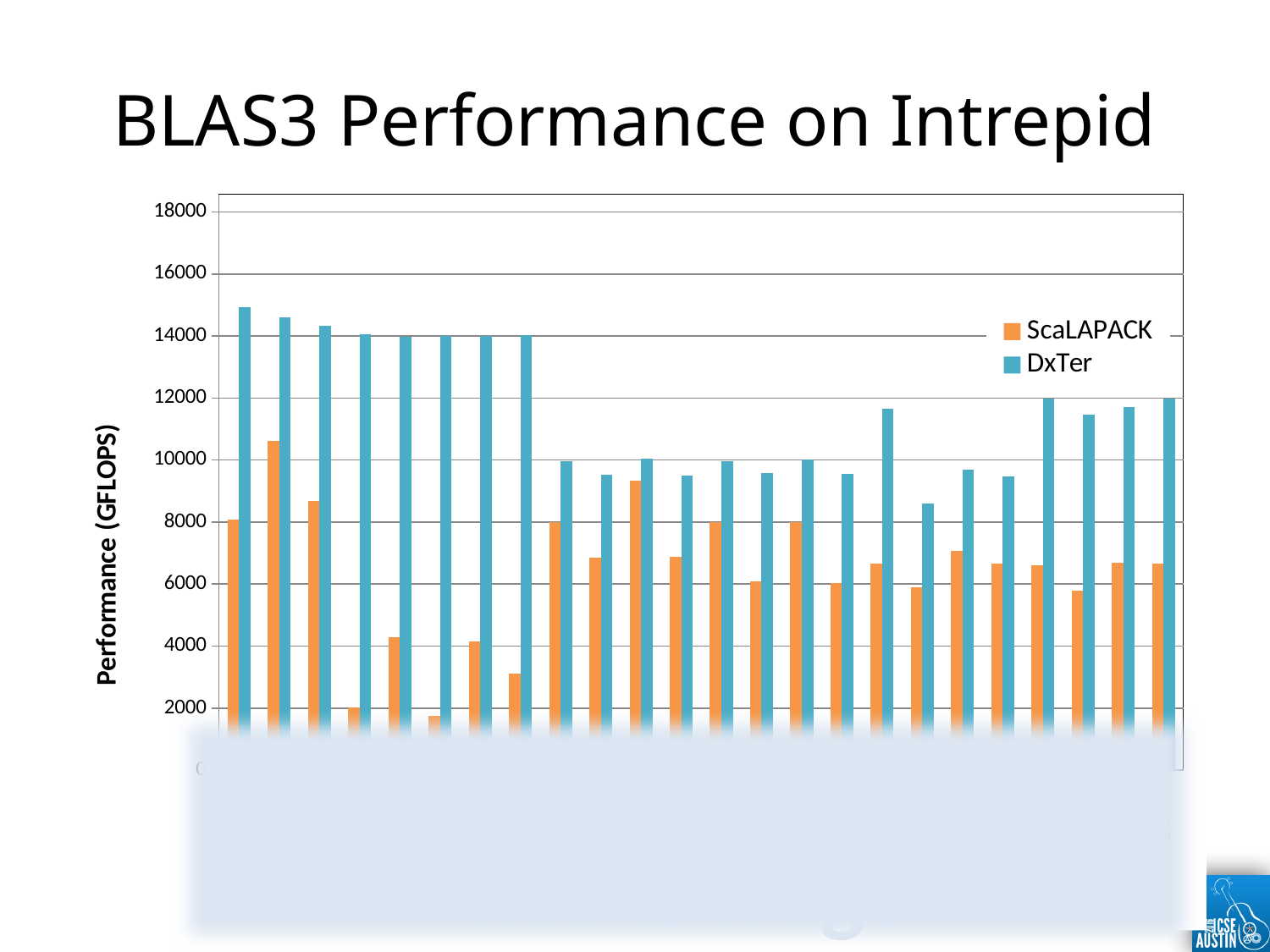
Does any DxTer bar exceed 16000? no What kind of chart is shown on the slide? bar chart Which series has the higher value in every category, ScaLAPACK or DxTer? DxTer Is the highest ScaLAPACK value greater or less than 10000? greater What is the highest tick value shown on the vertical axis? 18000 What are the two series named in the legend? ScaLAPACK and DxTer Is the highest DxTer value greater or less than 14000? greater How many series does the legend list? 2 What is the title of the chart? BLAS3 Performance on Intrepid How many categories (pairs of bars) are plotted in the chart? 24